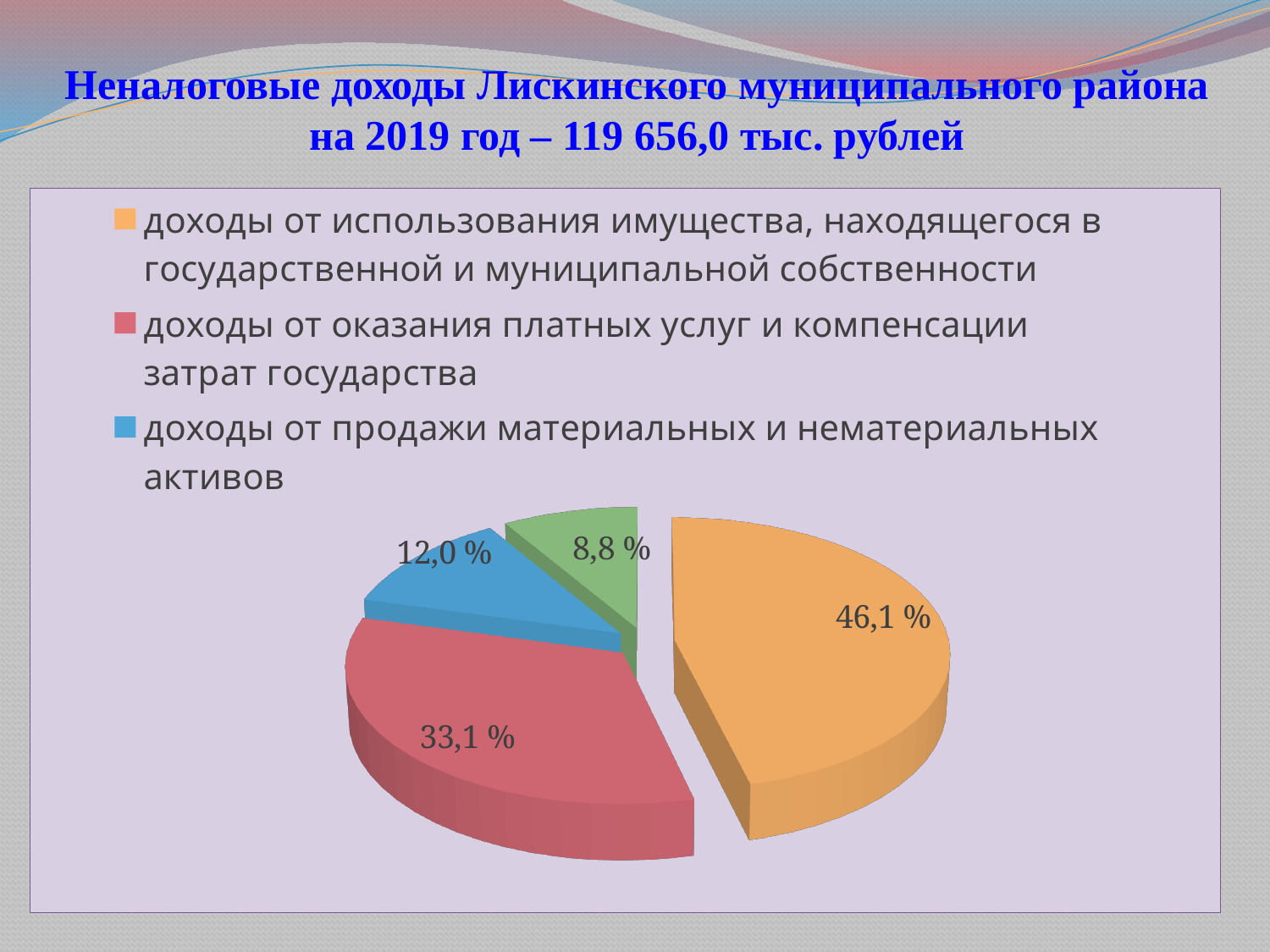
What total amount of non-tax revenue for 2019 is stated in the slide title? 119 656,0 тыс. рублей What share of the pie does the slice for доходы от использования имущества, находящегося в государственной и муниципальной собственности have? 46,1 % What is the difference between the slice for доходы от использования имущества and the slice for доходы от оказания платных услуг и компенсации затрат государства? 13,0 % How many entries does the legend list? 3 Which category has the largest slice of the pie? доходы от использования имущества, находящегося в государственной и муниципальной собственности What kind of chart is shown on the slide? pie chart What share of the pie does the slice for доходы от оказания платных услуг и компенсации затрат государства have? 33,1 % Which is larger: the slice for доходы от оказания платных услуг и компенсации затрат государства or the slice for доходы от продажи материальных и нематериальных активов? доходы от оказания платных услуг и компенсации затрат государства What share of the pie does the slice for доходы от продажи материальных и нематериальных активов have? 12,0 % What is the value printed on the smallest slice of the pie? 8,8 % How many slices does the pie chart have? 4 What colour is the slice for доходы от продажи материальных и нематериальных активов? blue